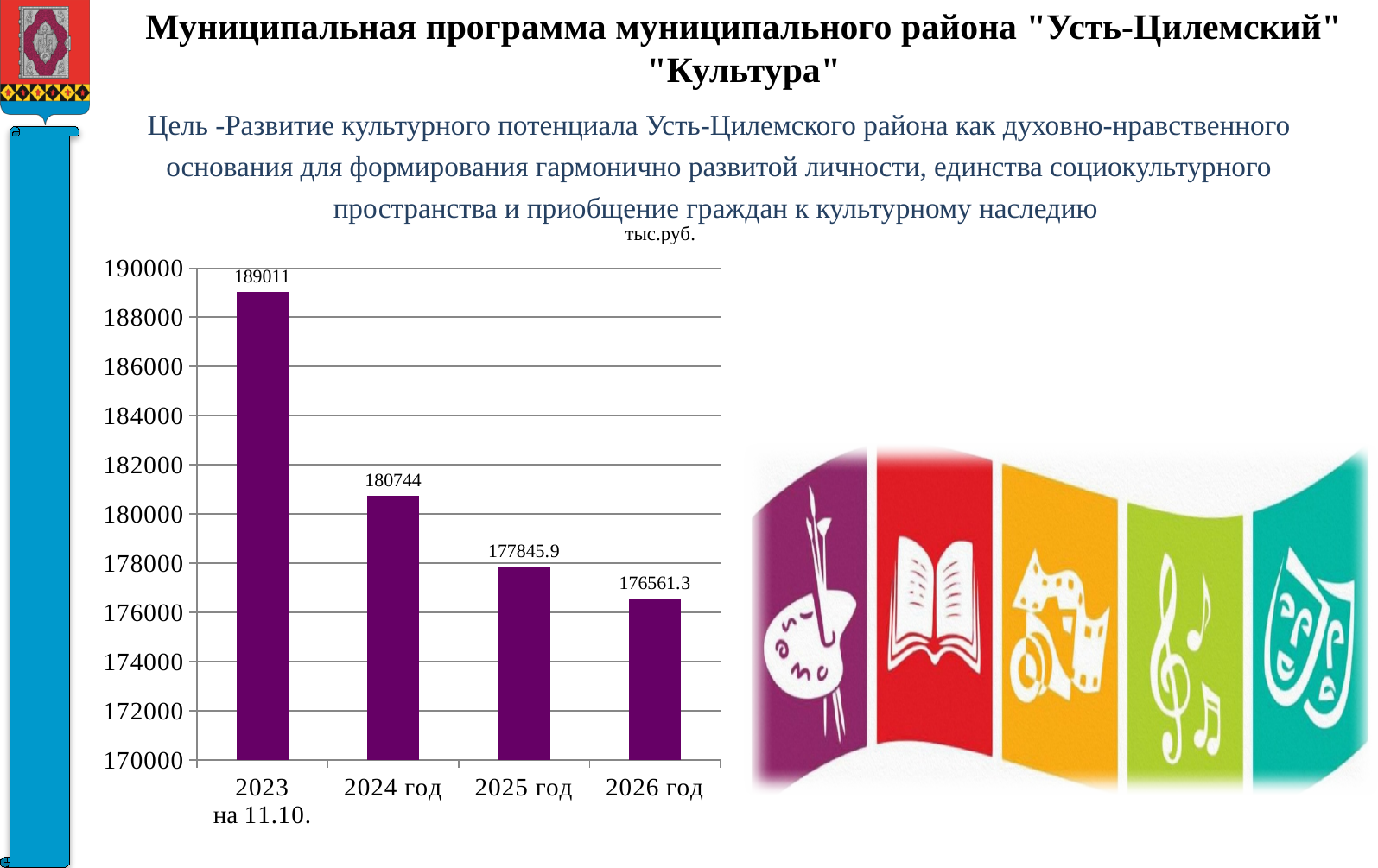
What is the value for 2024 год? 180744 What is the difference between the values for 2023 на 11.10. and 2024 год? 8267 Which category has the lowest value? 2026 год Do the values rise or fall from 2023 to 2026 along the x axis? fall What is the value for 2025 год? 177845.9 How many categories are shown on the x axis? 4 What is the value for 2023 на 11.10.? 189011 Is the value for 2025 год greater or less than 178000? less Which category has the highest value? 2023 на 11.10. What is the difference between the values for 2025 год and 2026 год? 1284.6 What is the value for 2026 год? 176561.3 Which is larger, the value for 2024 год or the value for 2025 год? 2024 год